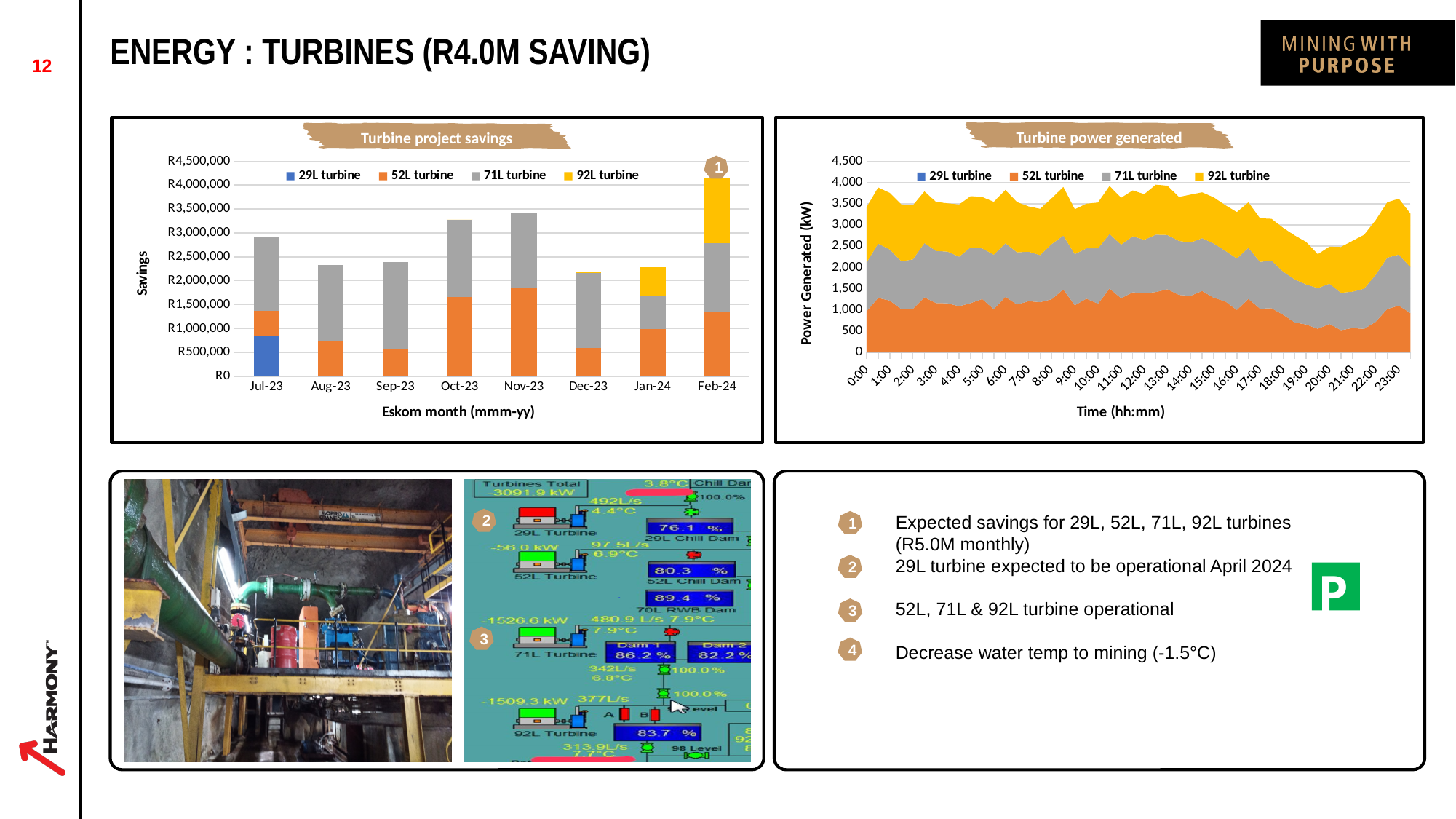
What kind of chart is the 'Turbine power generated' chart? area chart In the 'Turbine project savings' chart, is the total savings for Aug-23 greater or less than R2,500,000? less What kind of chart is the 'Turbine project savings' chart? bar chart In the 'Turbine project savings' chart, which month has larger total savings, Feb-24 or Jan-24? Feb-24 In the 'Turbine project savings' chart, which month has the highest total savings? Feb-24 How many series does the legend of the 'Turbine project savings' chart list? 4 How many series does the legend of the 'Turbine power generated' chart list? 4 In the 'Turbine project savings' chart, which is the only month with a 29L turbine contribution? Jul-23 In the 'Turbine power generated' chart, does the total power generated rise or fall between 16:00 and 19:00? fall In the 'Turbine power generated' chart, is the total power generated at 13:00 greater or less than 3,500 kW? greater In the 'Turbine project savings' chart, is the total savings for Oct-23 greater or less than R3,000,000? greater How many months are shown on the x axis of the 'Turbine project savings' chart? 8